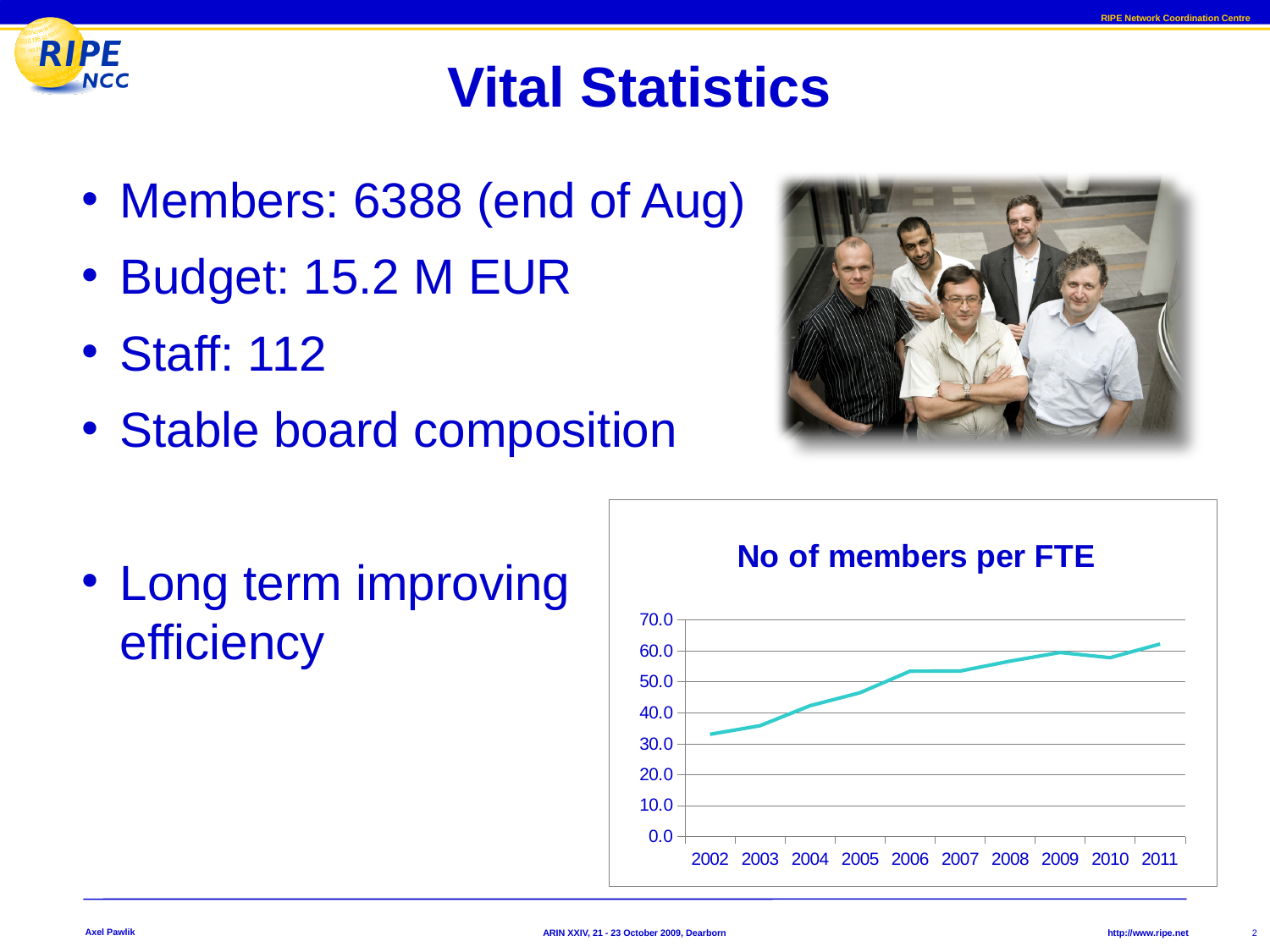
How many years are plotted on the x axis of the chart? 10 Which year has a larger value, 2004 or 2008? 2008 Which year has the lowest number of members per FTE? 2002 Is the value for 2005 greater or less than 50.0? less Which year has the highest number of members per FTE? 2011 What is the first year shown on the x axis of the chart? 2002 What is the title of the chart on the slide? No of members per FTE What kind of chart is shown on the slide? line chart Do the values in the chart generally rise or fall from 2002 to 2011? rise Is the value for 2011 greater or less than 50.0? greater Is the value for 2002 greater or less than 40.0? less